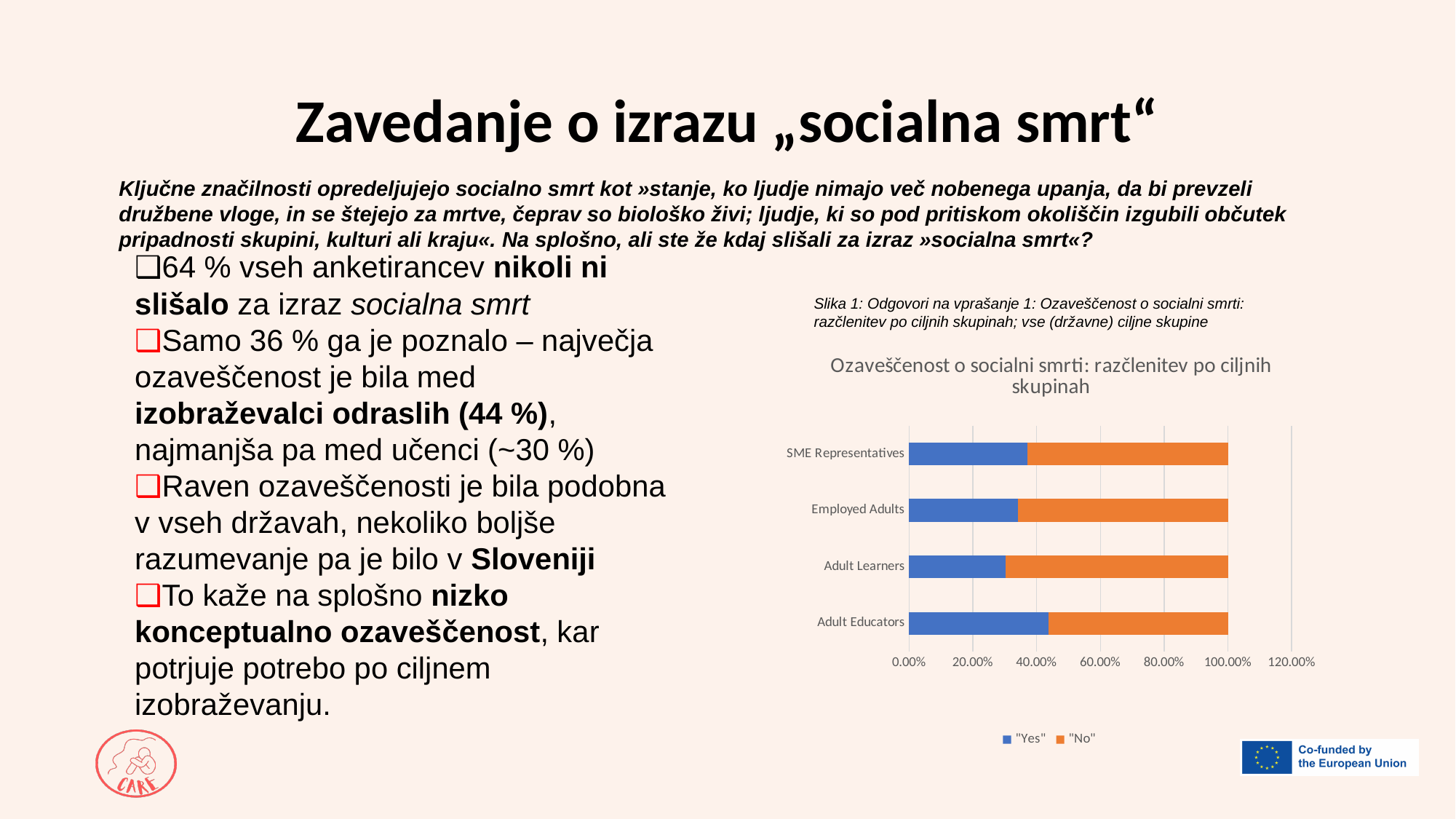
Is the "Yes" share for Adult Learners greater or less than 40.00%? less Is the "Yes" share for Adult Educators greater or less than 40.00%? greater Which has a larger "Yes" share: Adult Educators or Adult Learners? Adult Educators What is the title of the chart? Ozaveščenost o socialni smrti: razčlenitev po ciljnih skupinah How many target groups (categories) are shown on the chart? 4 What kind of chart is shown on the slide? Stacked bar chart Which target group has the lowest "Yes" share in the chart? Adult Learners What is the total of the stacked bar for SME Representatives? 100.00% How many series does the chart legend list? 2 Which series is shown in orange in the chart? "No" Which target group has the highest "Yes" share in the chart? Adult Educators Is the "Yes" share for Employed Adults greater or less than 40.00%? less